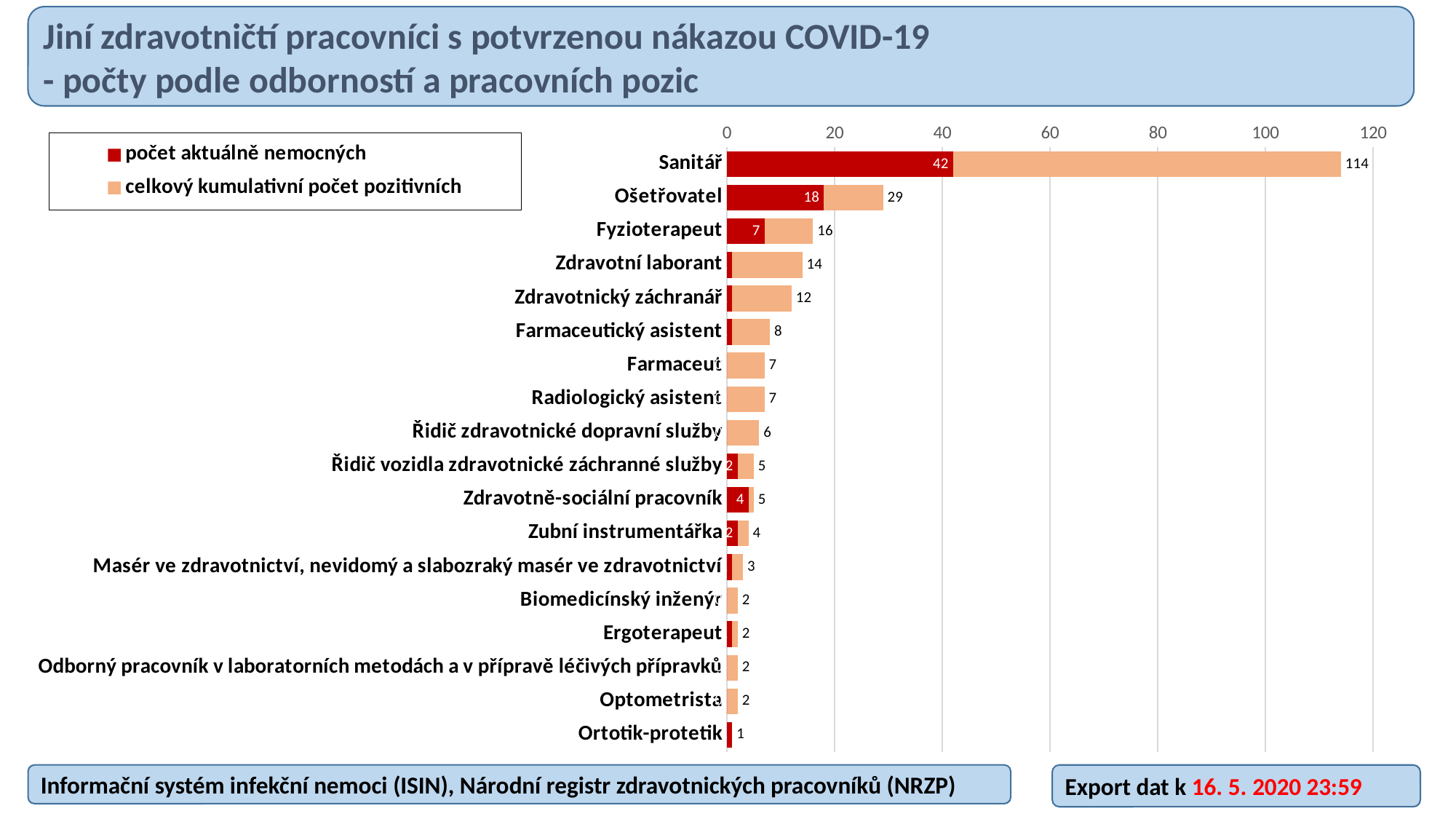
What is the difference between the cumulative number of positive cases for Sanitář and Ošetřovatel? 85 How many series does the legend list? 2 What is the cumulative number of positive cases for Zdravotnický záchranář? 12 Which has a higher cumulative number of positive cases, Zdravotní laborant or Farmaceutický asistent? Zdravotní laborant What is the cumulative number of positive cases for Fyzioterapeut? 16 Which category has the lowest cumulative number of positive cases? Ortotik-protetik What is the number of currently ill (počet aktuálně nemocných) for Ošetřovatel? 18 What is the cumulative number of positive cases (celkový kumulativní počet pozitivních) for Sanitář? 114 How many categories (professions) are shown in the chart? 18 Is the cumulative number of positive cases for Sanitář greater or less than 100? greater Which category has the highest cumulative number of positive cases? Sanitář What type of chart is shown on the slide? bar chart